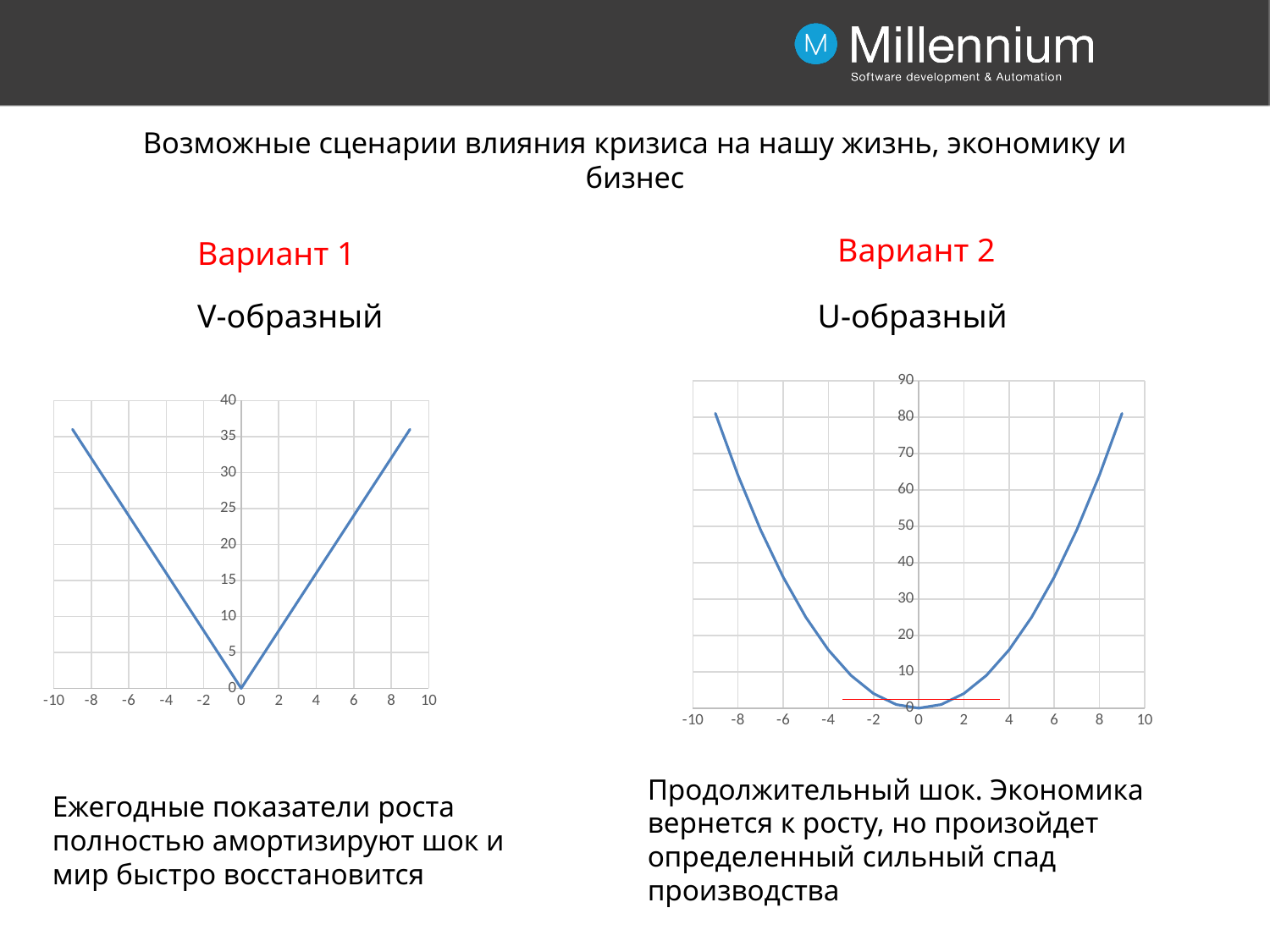
In the left chart (V-образный), which is larger: the value at x = -8 or the value at x = -2? x = -8 What kind of chart is the right chart titled "U-образный"? line chart In the right chart (U-образный), what is the value of the line at x = 0? 0 In the right chart (U-образный), do the values rise or fall as x goes from -10 to 0? fall What kind of chart is the left chart titled "V-образный"? line chart In the left chart (V-образный), do the values rise or fall as x goes from 0 to 10? rise In the left chart (V-образный), is the value at x = -8 greater or less than 25? greater What is the highest tick shown on the y axis of the right chart (U-образный)? 90 In the left chart (V-образный), is the value at x = 2 greater or less than 15? less In the right chart (U-образный), is the value at x = 2 greater or less than 20? less In the left chart (V-образный), at which x value is the line at its lowest point? 0